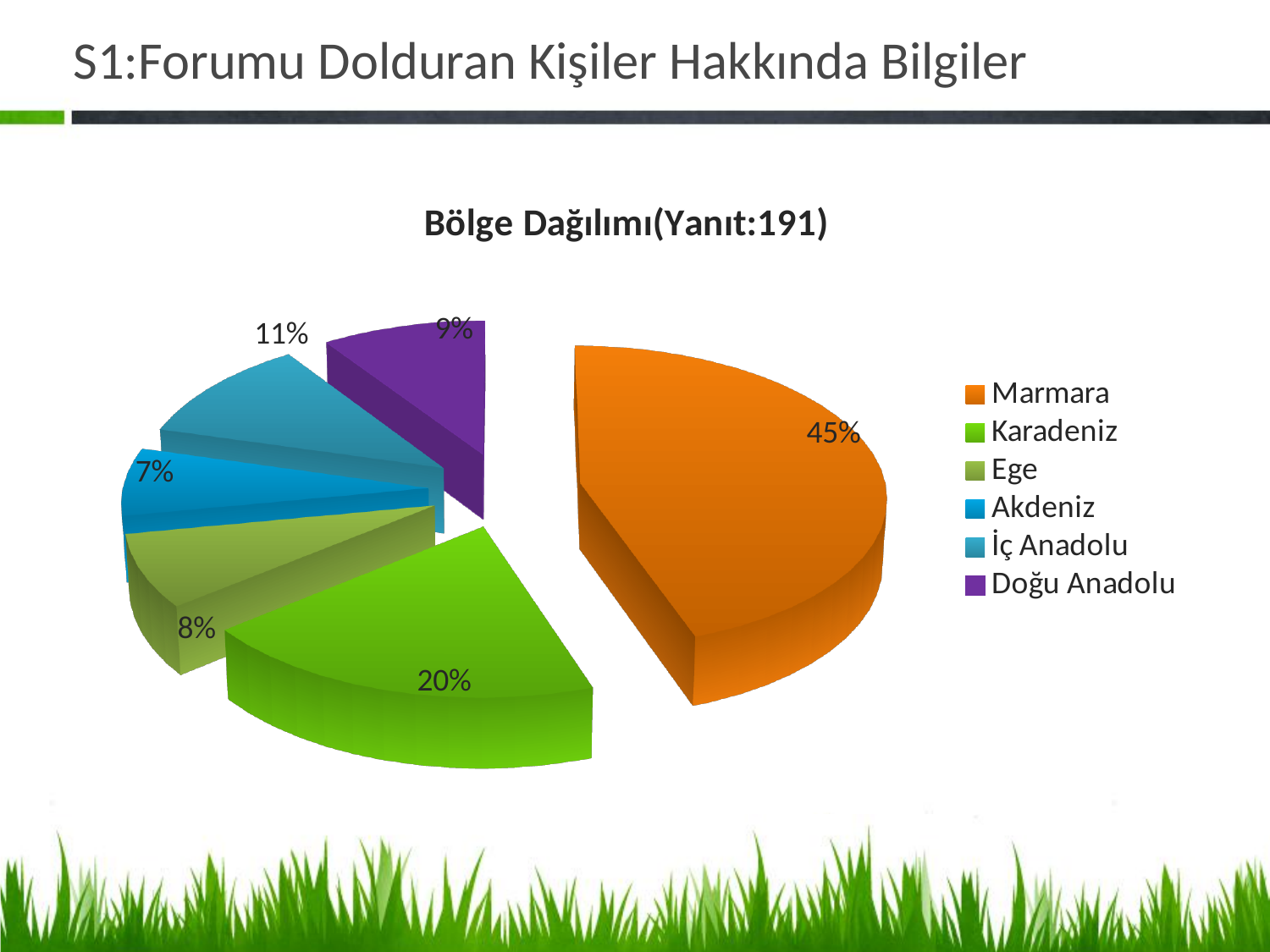
What share of the pie does Marmara have? 45% What is the value shown for Doğu Anadolu? 9% Which region has the largest slice of the pie? Marmara What share of the pie does Karadeniz have? 20% What kind of chart is shown on the slide? Pie chart How many regions are listed in the legend? 6 What is the value shown for Ege? 8% What is the title of the chart? Bölge Dağılımı(Yanıt:191) What is the value shown for İç Anadolu? 11% What is the difference between the Marmara and Karadeniz shares? 25% What is the value shown for Akdeniz? 7% Which region has the smallest slice of the pie? Akdeniz